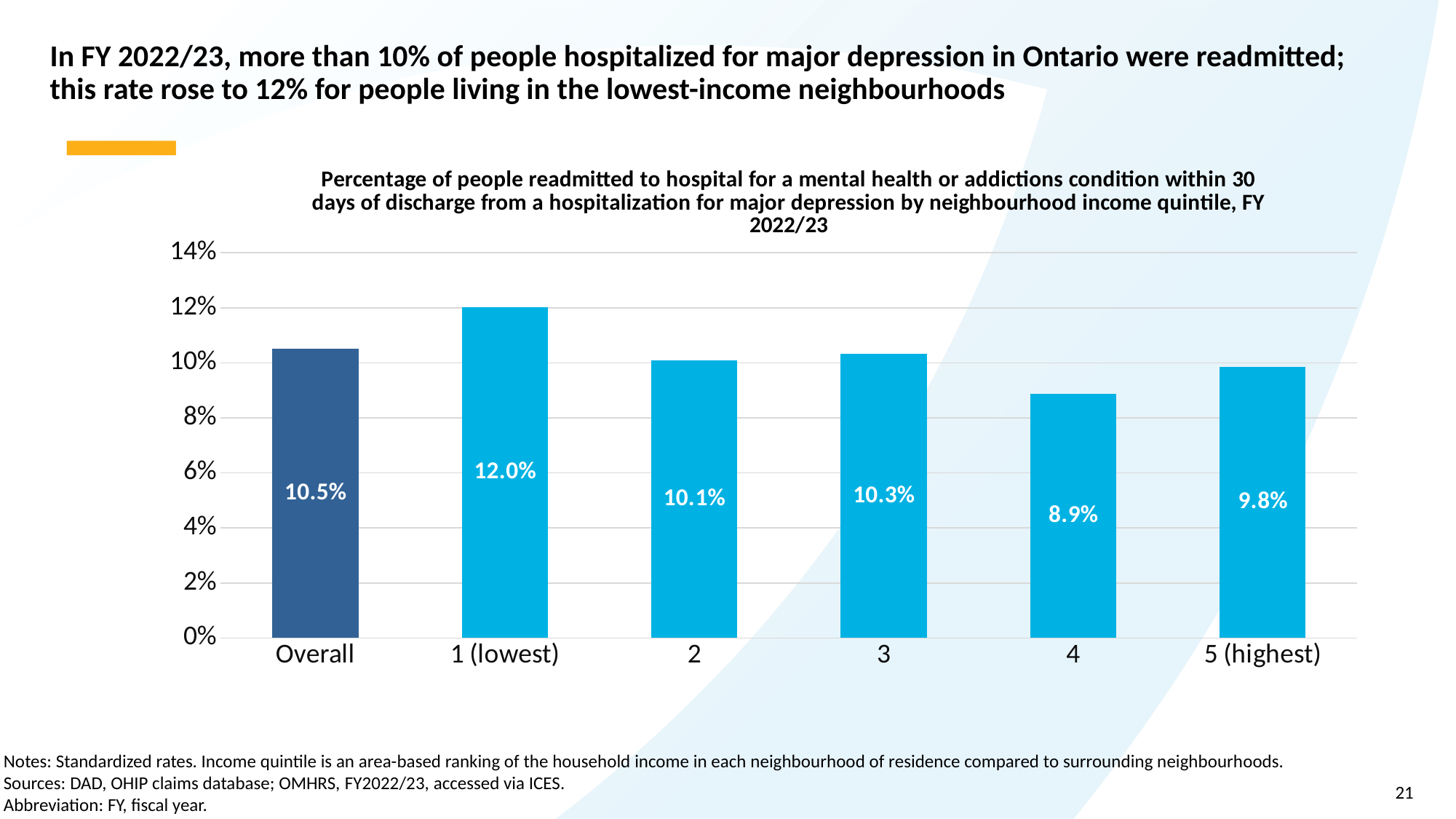
Which category has the lowest readmission percentage? 4 What is the readmission percentage for income quintile 4? 8.9% What type of chart is shown on the slide? Bar chart Which category has the highest readmission percentage? 1 (lowest) What is the readmission percentage for income quintile 1 (lowest)? 12.0% What is the readmission percentage for the Overall category? 10.5% What is the difference in percentage points between quintile 1 (lowest) and quintile 5 (highest)? 2.2 Is the value for quintile 4 greater or less than 10%? less Which has a higher readmission percentage, quintile 2 or quintile 3? 3 What is the readmission percentage for income quintile 5 (highest)? 9.8% How many bars are shown in the chart? 6 Which bar is shown in a darker blue colour than the others? Overall